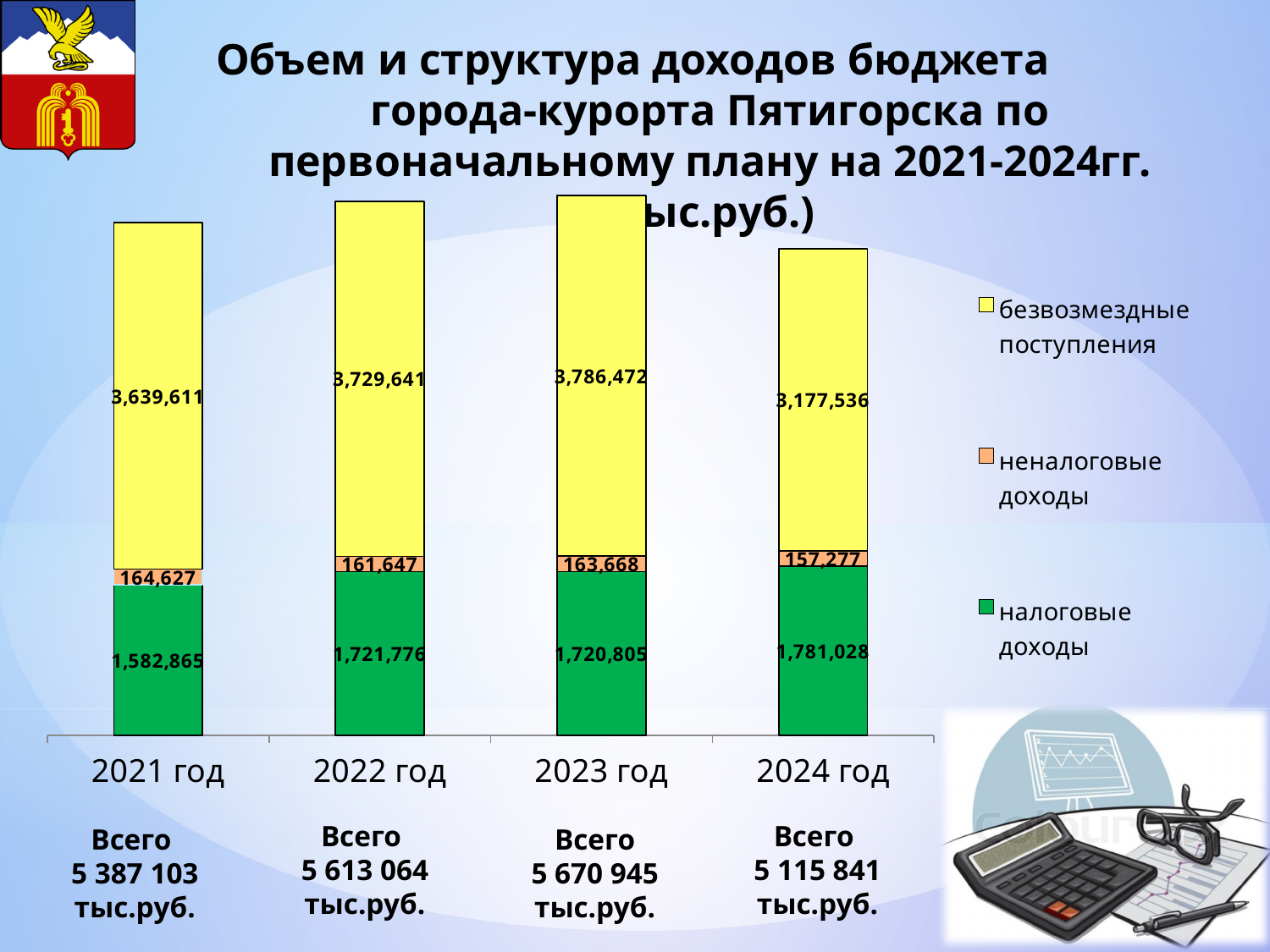
In which year are неналоговые доходы the lowest? 2024 год What is the total (Всего) for 2022 год? 5 613 064 тыс.руб. Which year has larger налоговые доходы, 2021 год or 2024 год? 2024 год What kind of chart is shown on the slide? Stacked bar chart What is the value of безвозмездные поступления for 2023 год? 3,786,472 How many years are shown on the x axis? 4 By how much do безвозмездные поступления in 2023 год exceed those in 2024 год? 608,936 How many series does the legend list? 3 What is the value of неналоговые доходы for 2024 год? 157,277 What is the value of налоговые доходы for 2021 год? 1,582,865 In which year are безвозмездные поступления the highest? 2023 год Which colour represents налоговые доходы in the chart? Green